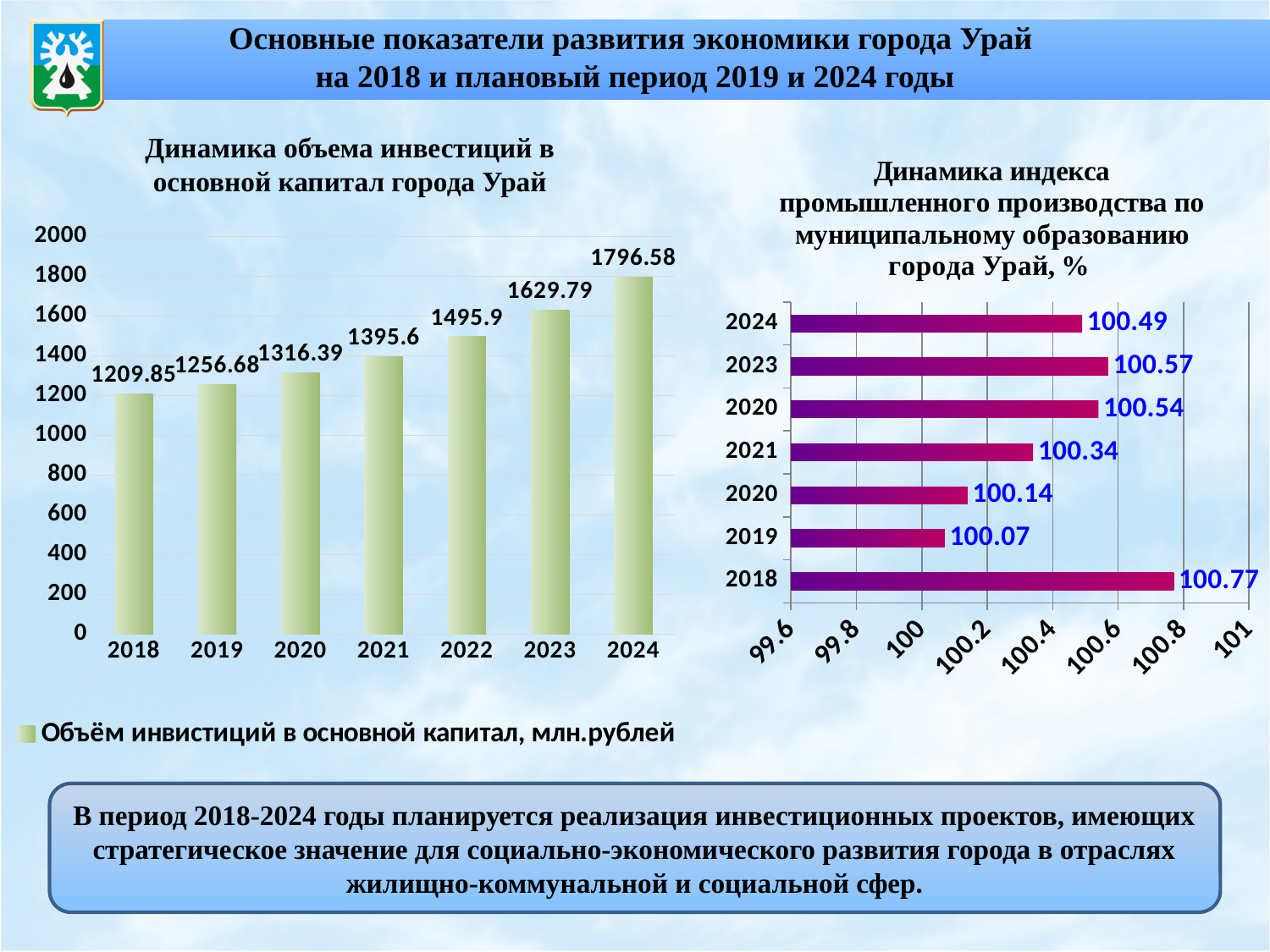
How many years are shown in the chart 'Динамика объема инвестиций в основной капитал города Урай'? 7 In the chart 'Динамика индекса промышленного производства по муниципальному образованию города Урай, %', which year has the highest value? 2018 What type of chart is 'Динамика объема инвестиций в основной капитал города Урай'? bar chart In the chart 'Динамика объема инвестиций в основной капитал города Урай', what is the value for 2021? 1395.6 What does the legend entry for the left chart say? Объём инвистиций в основной капитал, млн.рублей In the chart 'Динамика индекса промышленного производства по муниципальному образованию города Урай, %', which is larger: the value for 2021 or the value for 2024? 2024 In the chart 'Динамика объема инвестиций в основной капитал города Урай', what is the difference between the values for 2024 and 2023? 166.79 In the chart 'Динамика объема инвестиций в основной капитал города Урай', do the values rise or fall from 2018 to 2024? rise In the chart 'Динамика индекса промышленного производства по муниципальному образованию города Урай, %', what is the value for 2023? 100.57 In the chart 'Динамика объема инвестиций в основной капитал города Урай', what is the value for 2024? 1796.58 In the chart 'Динамика объема инвестиций в основной капитал города Урай', which year has the lowest value? 2018 In the chart 'Динамика индекса промышленного производства по муниципальному образованию города Урай, %', what is the value for 2019? 100.07